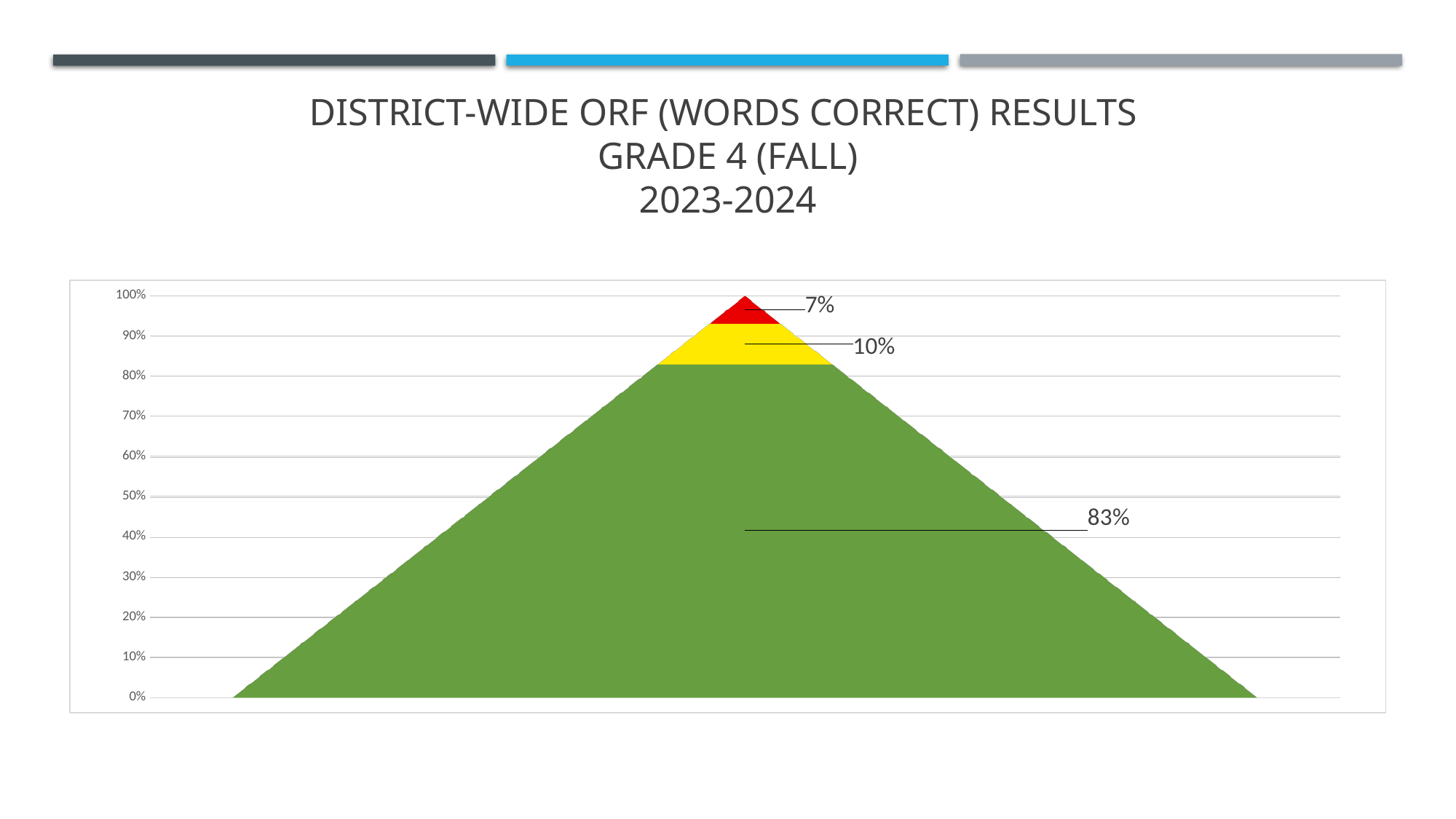
What percentage does the green segment of the pyramid represent? 83% What is the title of the chart on the slide? District-Wide ORF (Words Correct) Results Grade 4 (Fall) 2023-2024 What percentage does the red segment at the top of the pyramid represent? 7% What percentage does the yellow segment of the pyramid represent? 10% How many segments are shown in the pyramid? 3 What is the total of the three segments shown in the pyramid? 100% Which is larger, the yellow segment or the red segment? Yellow What is the difference between the green segment's value and the yellow segment's value? 73% Which coloured segment has the smallest value? Red Is the value for the green segment greater or less than 80%? greater What is the difference between the yellow segment's value and the red segment's value? 3% Which coloured segment has the largest value? Green